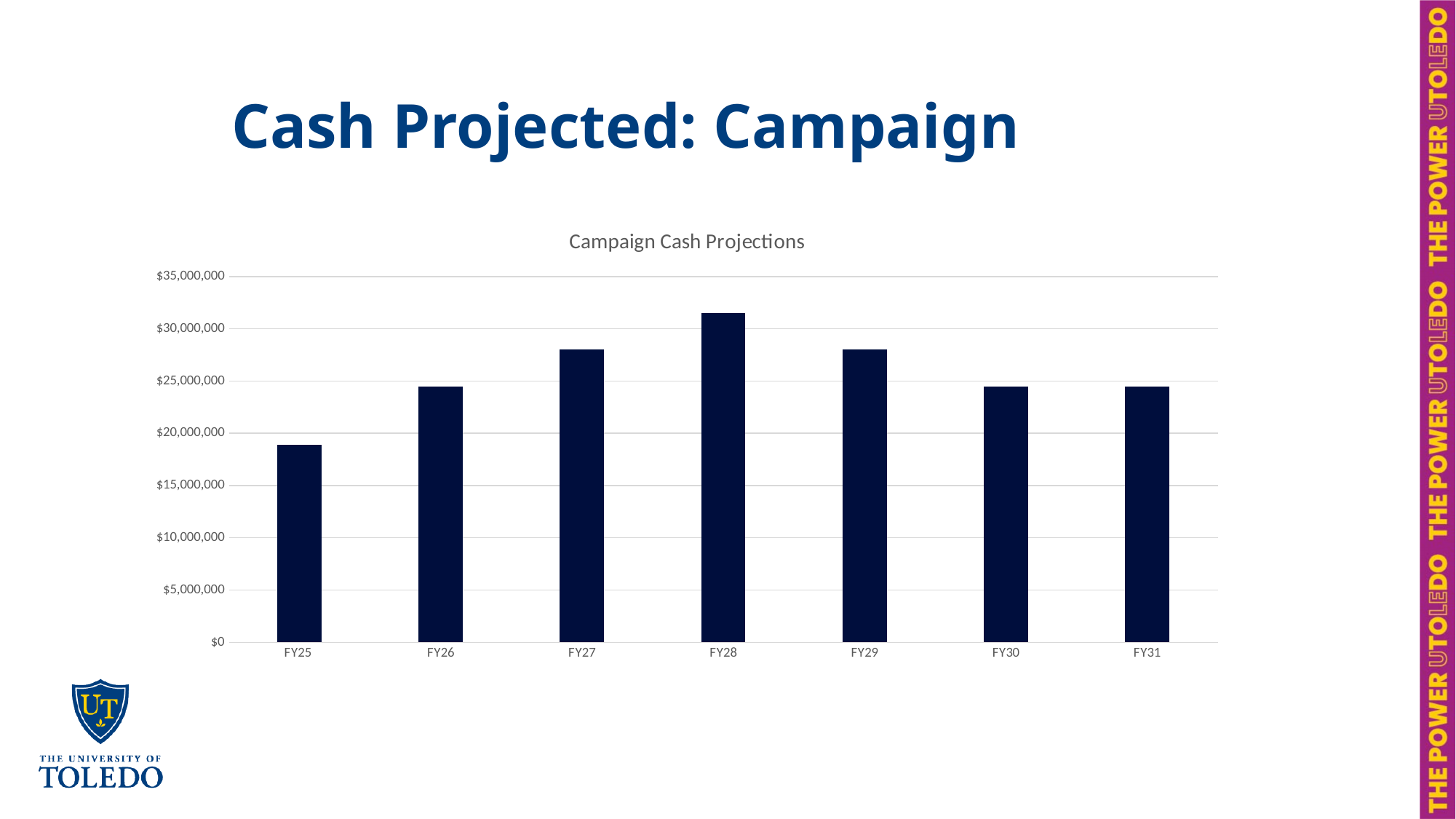
How many fiscal years are plotted on the x axis? 7 Is the value for FY31 greater or less than $25,000,000? less Which fiscal year has the highest projected campaign cash? FY28 Which is larger, the value for FY28 or the value for FY30? FY28 Do the values rise or fall from FY28 to FY31? fall What kind of chart is shown on the slide? Bar chart Is the value for FY28 greater or less than $30,000,000? greater Is the value for FY25 greater or less than $20,000,000? less Which fiscal year has the lowest projected campaign cash? FY25 What is the title of the chart? Campaign Cash Projections Do the values rise or fall from FY25 to FY28? rise